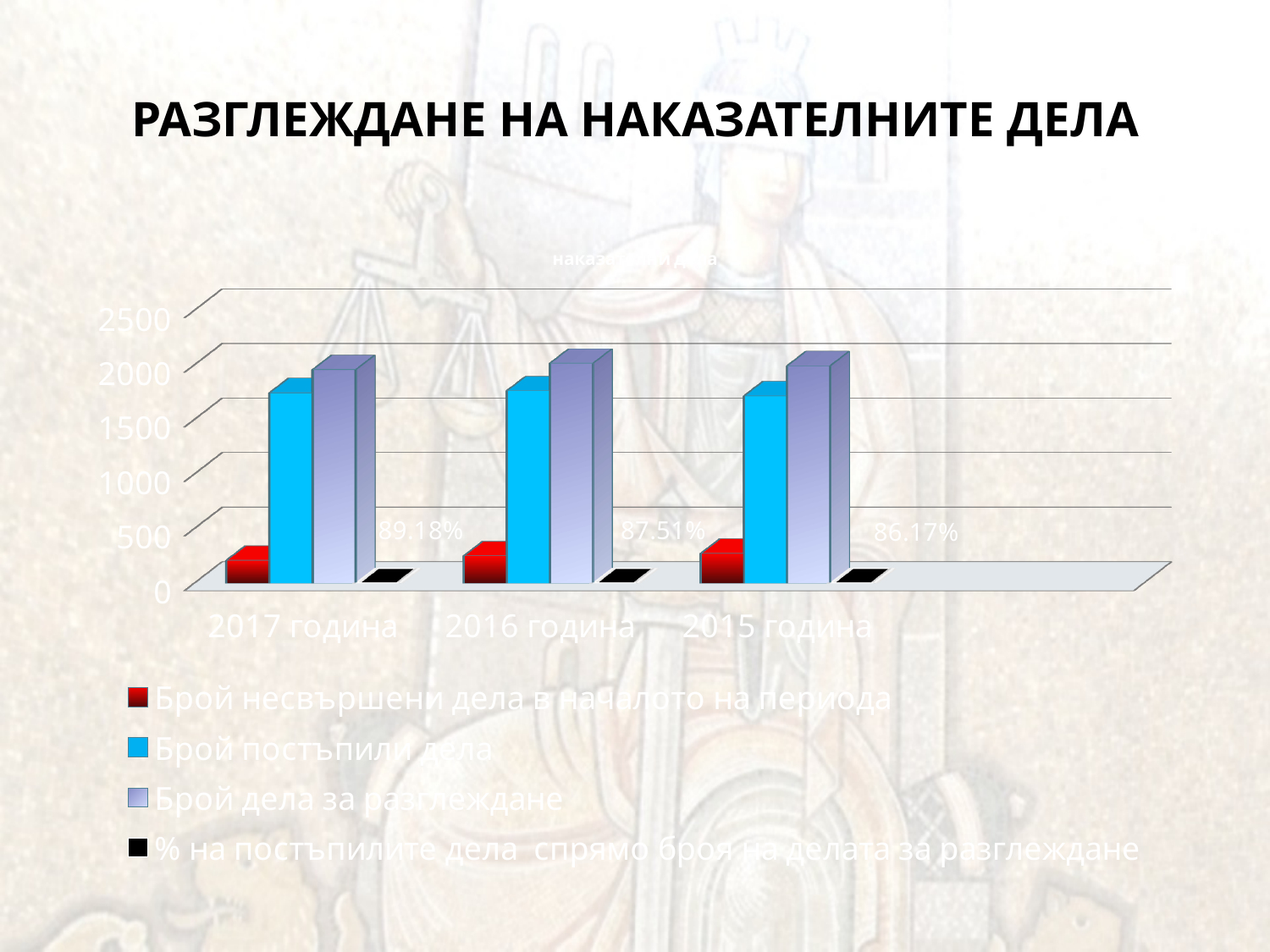
What is the value of the series '% на постъпилите дела спрямо броя на делата за разглеждане' for 2017 година? 89.18% How many year categories are shown on the x axis? 3 Which year has the lowest value for '% на постъпилите дела спрямо броя на делата за разглеждане'? 2015 година What is the value of the series '% на постъпилите дела спрямо броя на делата за разглеждане' for 2015 година? 86.17% What kind of chart is shown on the slide? bar chart Is the percentage label for 2016 година larger or smaller than the one for 2015 година? larger What is the value of the series '% на постъпилите дела спрямо броя на делата за разглеждане' for 2016 година? 87.51% Which year has the highest value for '% на постъпилите дела спрямо броя на делата за разглеждане'? 2017 година How many series does the legend list? 4 Is the value of 'Брой несвършени дела в началото на периода' for 2016 година greater or less than 500? less Is the value of 'Брой постъпили дела' for 2017 година greater or less than 1500? greater What is the difference between the percentage labels for 2017 година and 2015 година? 3.01 percentage points